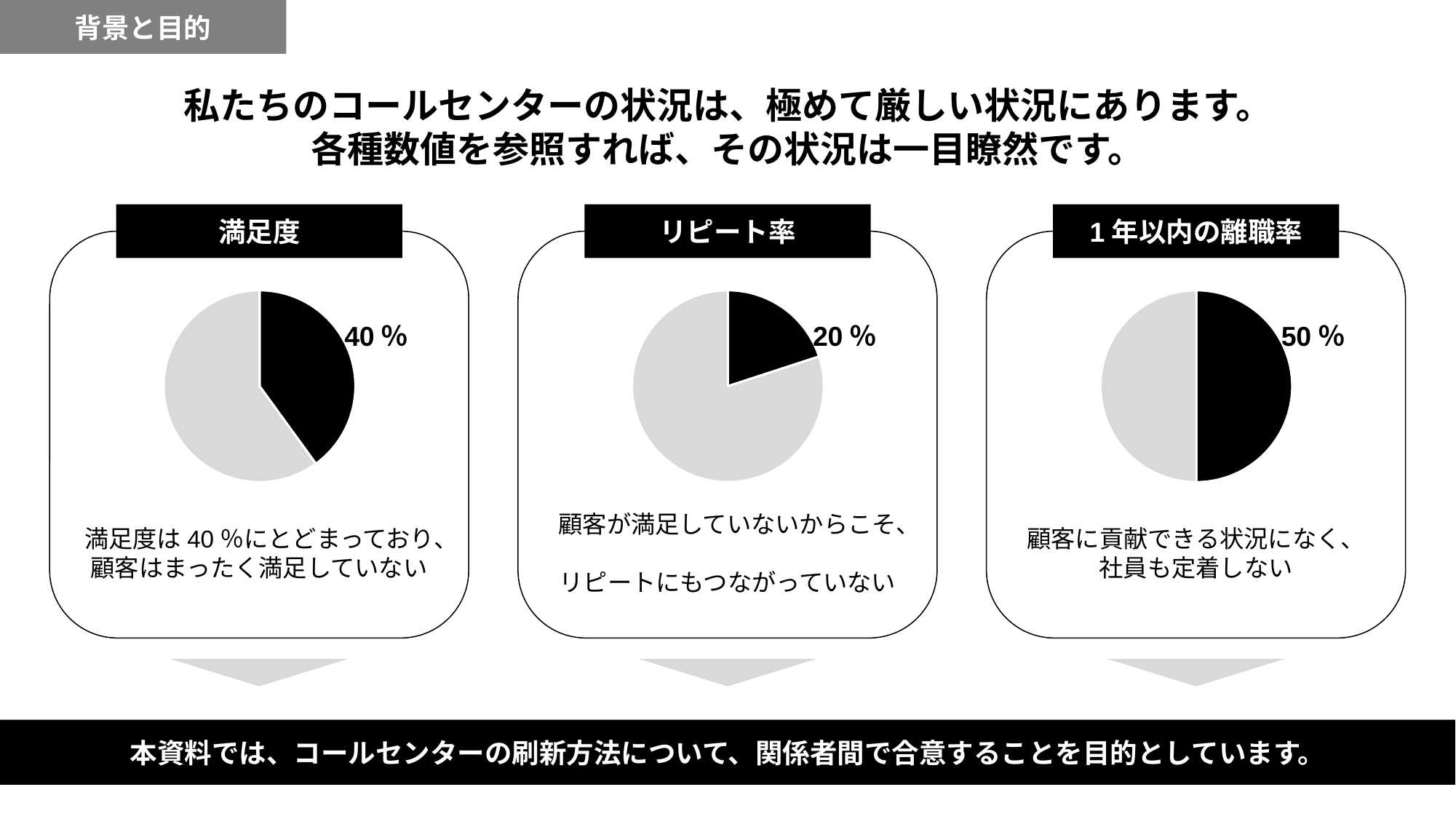
What kind of chart is used under the 満足度 heading? Pie chart What is the difference between the labelled value in the 1 年以内の離職率 pie chart and the labelled value in the 満足度 pie chart? 10 % What is the title of the pie chart on the right of the slide? 1 年以内の離職率 Which of the three pie charts has the largest labelled value? 1 年以内の離職率 In the 1 年以内の離職率 pie chart, what percentage is shown for the black slice? 50 % Which of the three pie charts has the smallest labelled value? リピート率 In the リピート率 pie chart, what percentage is shown for the black slice? 20 % In the 満足度 pie chart, what percentage is shown for the black slice? 40 % How many slices does the リピート率 pie chart have? 2 What is the difference between the labelled value in the 満足度 pie chart and the labelled value in the リピート率 pie chart? 20 % Which is larger: the labelled value in the 満足度 pie chart or the labelled value in the リピート率 pie chart? 満足度 How many pie charts are shown on the slide? 3